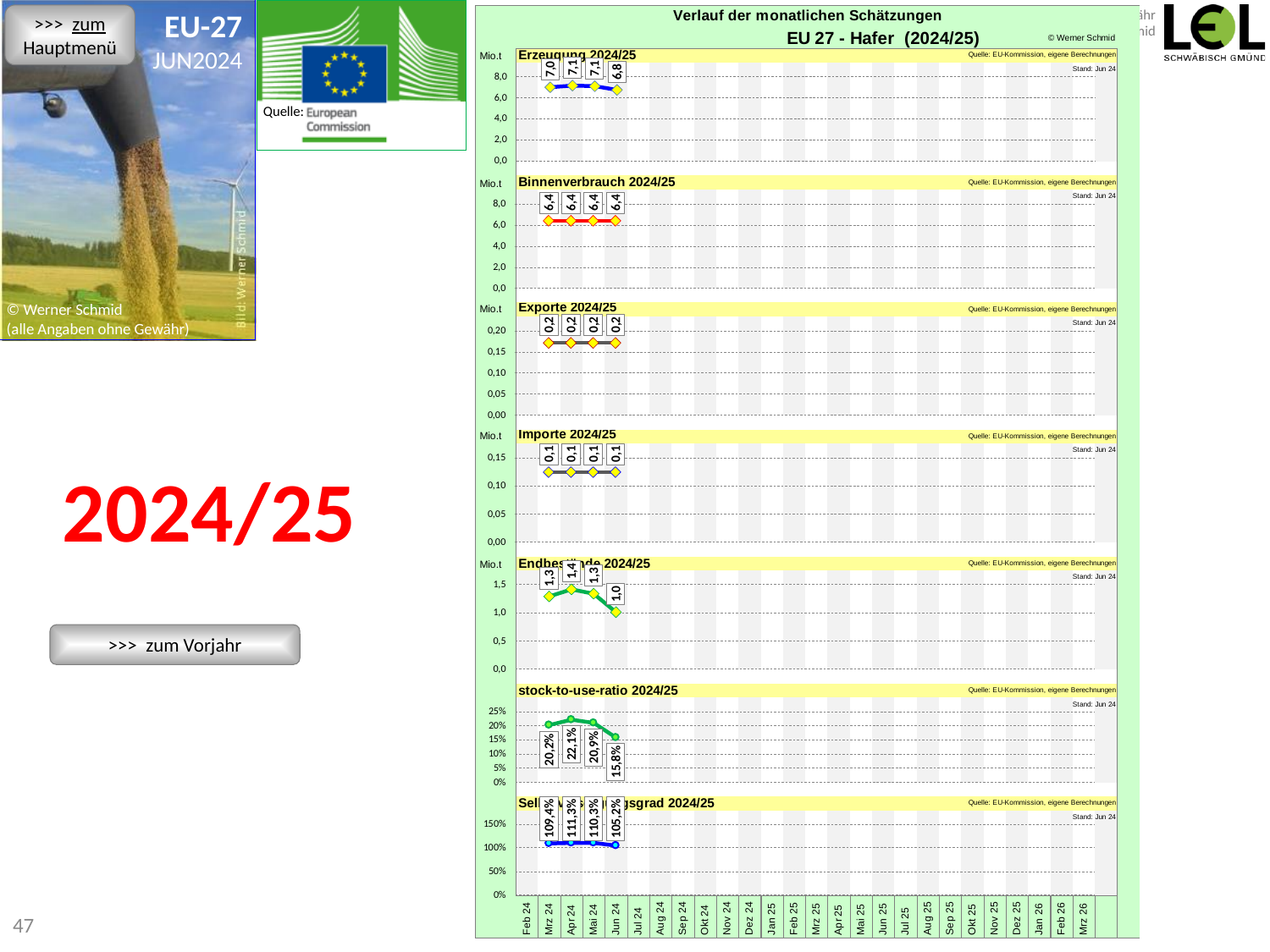
In the stock-to-use-ratio 2024/25 chart, what is the difference between the Apr 24 value and the Jun 24 value? 6,3 percentage points In the Exporte 2024/25 chart, what value is shown for each of the plotted months? 0,2 In the Binnenverbrauch 2024/25 chart, what value is shown for Jun 24? 6,4 In the Endbestände 2024/25 chart, which month has the highest value? Apr 24 In the bottom chart (Selbstversorgungsgrad 2024/25), what is the value for Jun 24? 105,2% In the Importe 2024/25 chart, what value is shown for Jun 24? 0,1 In the Erzeugung 2024/25 chart, what is the value of the first plotted point (Mrz 24)? 7,0 In the Erzeugung 2024/25 chart, what is the value of the latest estimate (Jun 24)? 6,8 How many data points are plotted in the Erzeugung 2024/25 chart? 4 In the bottom chart (Selbstversorgungsgrad 2024/25), is the Jun 24 value greater or less than 100%? greater In the stock-to-use-ratio 2024/25 chart, what is the value for Jun 24? 15,8% In the Endbestände 2024/25 chart, what is the value for Jun 24? 1,0